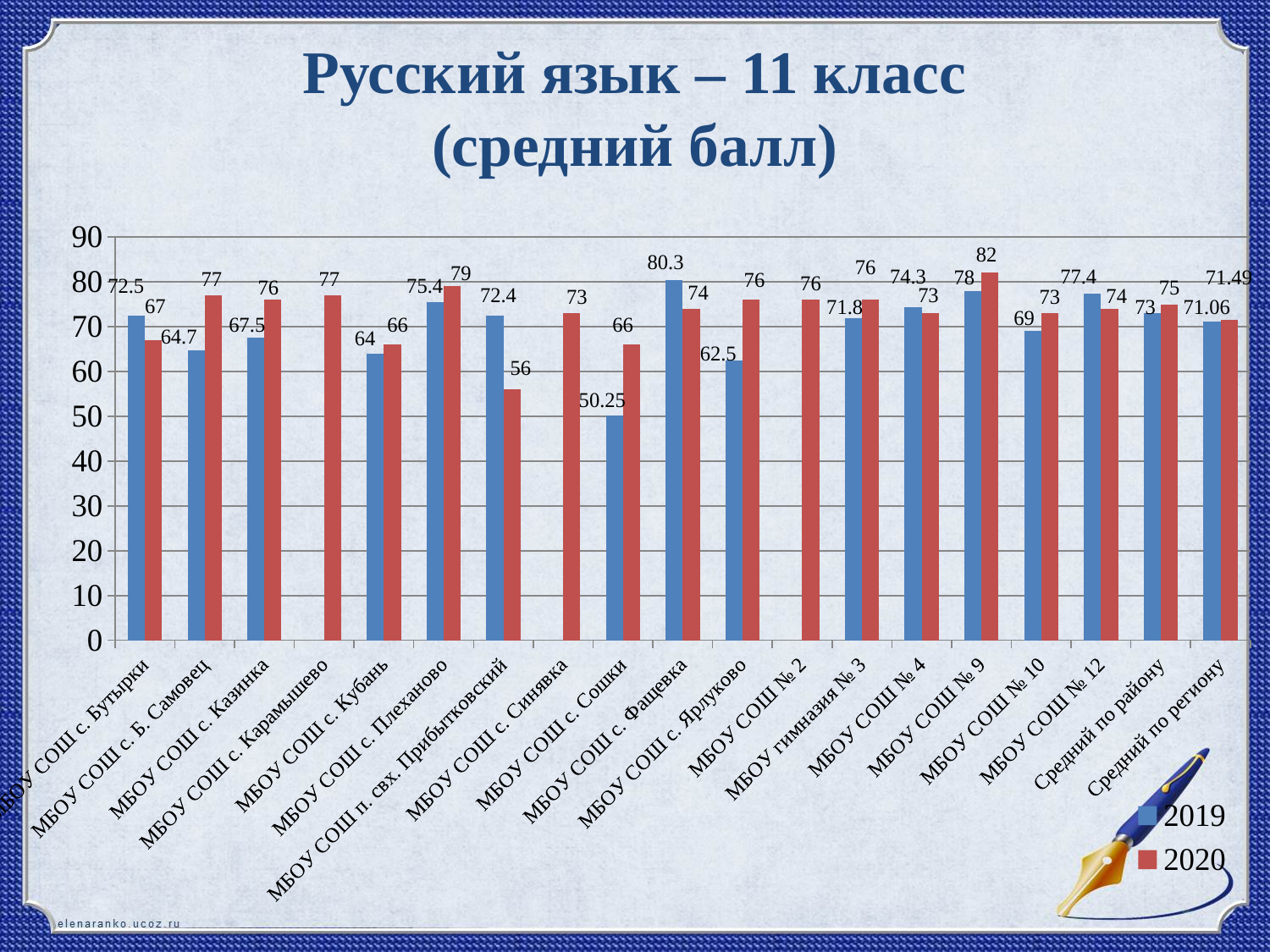
Which category has the highest 2020 value? МБОУ СОШ № 9 Which category has the lowest 2019 value? МБОУ СОШ с. Сошки What is the 2019 value for МБОУ СОШ с. Сошки? 50.25 What is the difference between the 2020 and 2019 values for МБОУ СОШ с. Б. Самовец? 12.3 What type of chart is shown on the slide? bar chart What is the 2020 value for Средний по региону? 71.49 What is the 2020 value for МБОУ СОШ № 9? 82 How many series does the legend list? 2 How many categories are shown on the x axis? 19 Which category has the lowest 2020 value? МБОУ СОШ п. свх. Прибытковский What is the title of the chart? Русский язык – 11 класс (средний балл) Which is larger for МБОУ СОШ с. Фащевка, the 2019 value or the 2020 value? 2019